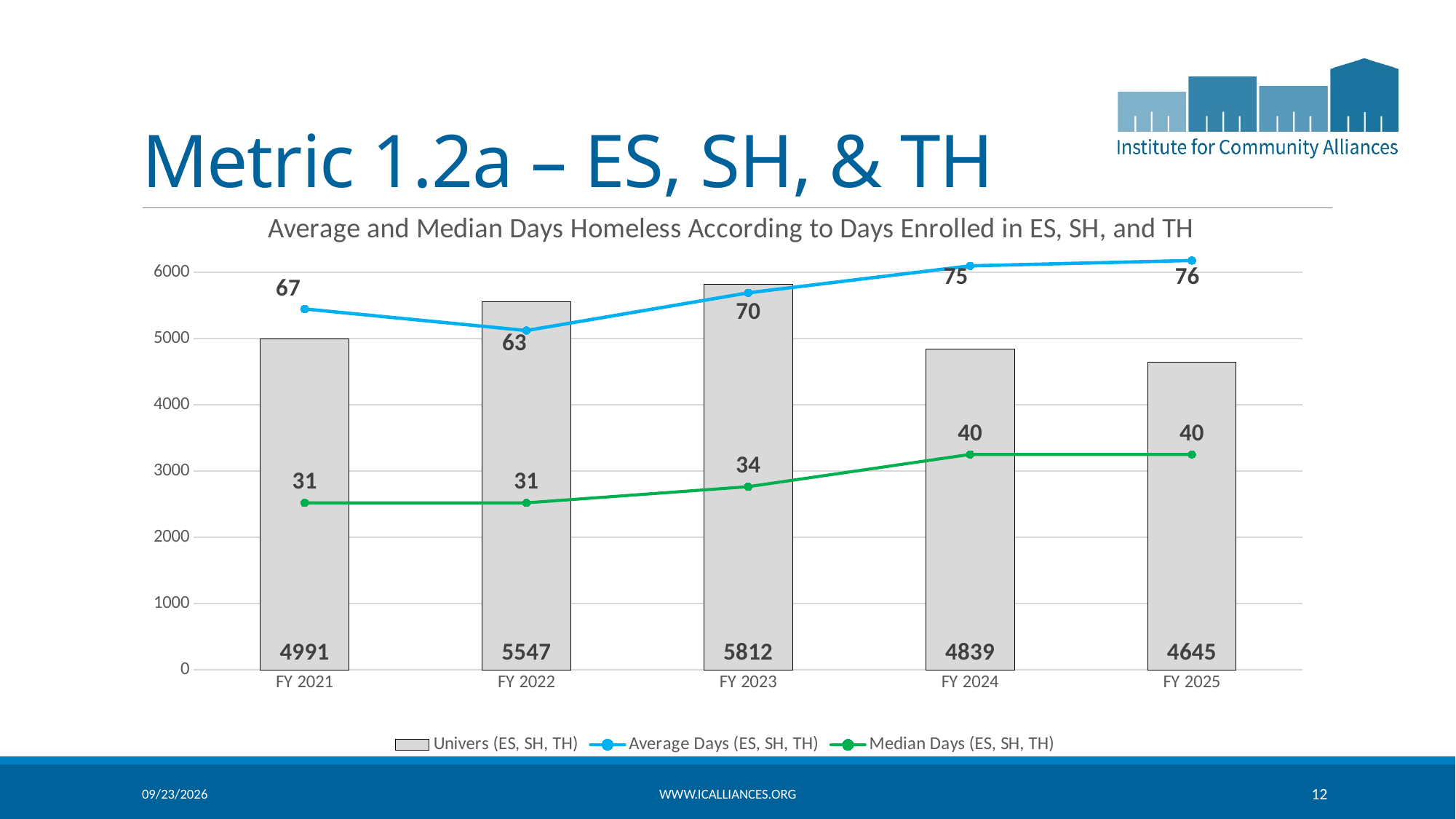
What is the Average Days (ES, SH, TH) value for FY 2022? 63 What kind of chart is this? Combined bar and line chart What is the Median Days (ES, SH, TH) value for FY 2024? 40 Does the Median Days (ES, SH, TH) line rise or fall from FY 2021 to FY 2025? rise What is the difference between the Univers (ES, SH, TH) values for FY 2022 and FY 2021? 556 Is the Univers (ES, SH, TH) bar for FY 2024 greater or less than 5000? less How many series does the legend list? 3 Which fiscal year has the highest Univers (ES, SH, TH) value? FY 2023 Which is larger, the Average Days value for FY 2021 or for FY 2022? FY 2021 Which fiscal year has the lowest Univers (ES, SH, TH) value? FY 2025 What is the Univers (ES, SH, TH) value for FY 2023? 5812 How many fiscal years are shown on the x axis? 5